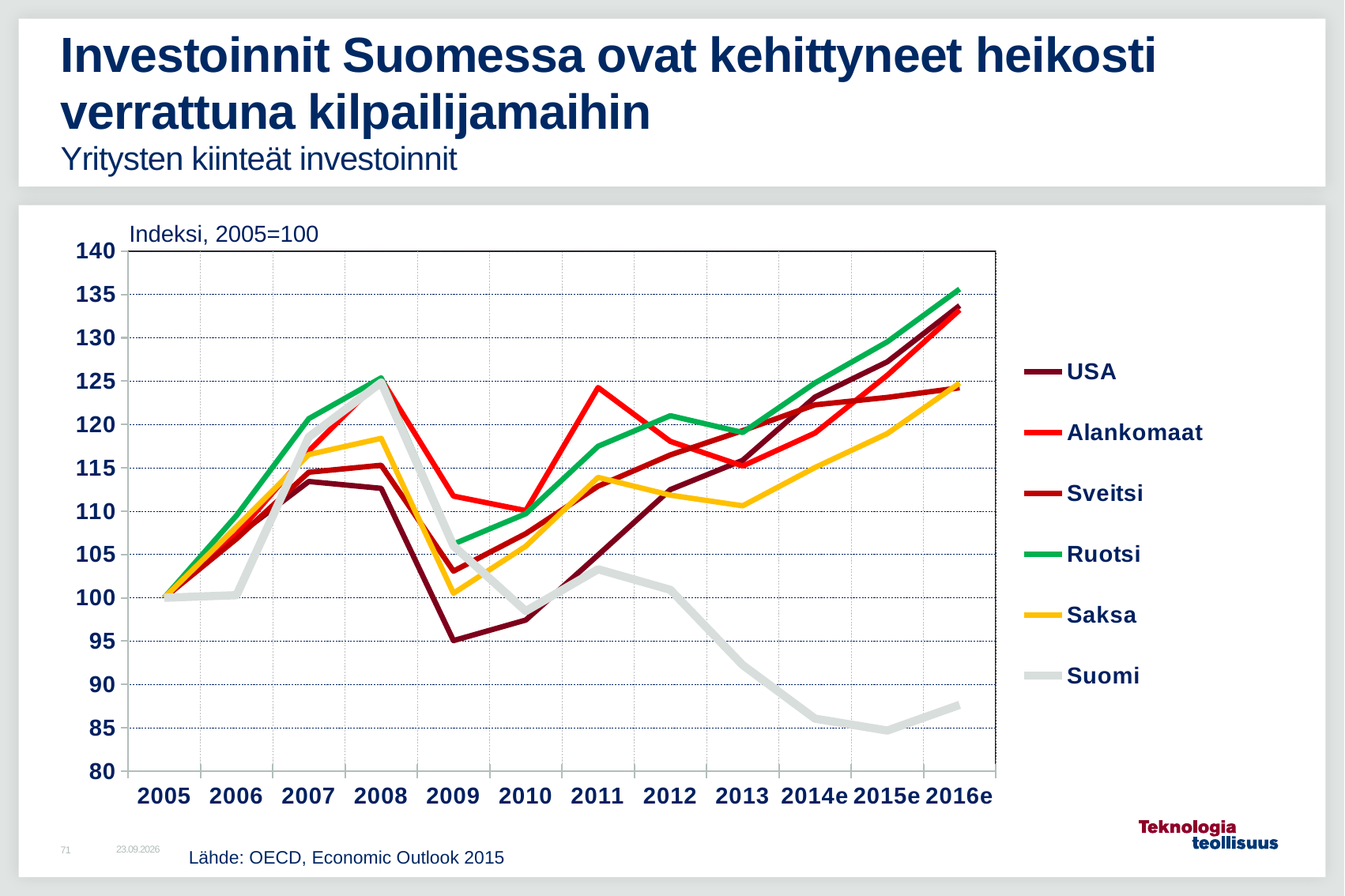
How many years are shown along the x axis? 12 Does the Suomi line rise or fall from 2011 to 2015e? fall What kind of chart is shown on the slide? line chart Is the value for Suomi in 2015e greater or less than 90? less Which country has the highest value in 2016e? Ruotsi What source is cited below the chart? OECD, Economic Outlook 2015 What is the index value for Suomi in 2005? 100 Which country has the lowest value in 2016e? Suomi Is the value for Ruotsi in 2016e greater or less than 130? greater How many series does the legend list? 6 Which country has the highest value in 2011? Alankomaat Which country has the lowest value in 2009? USA